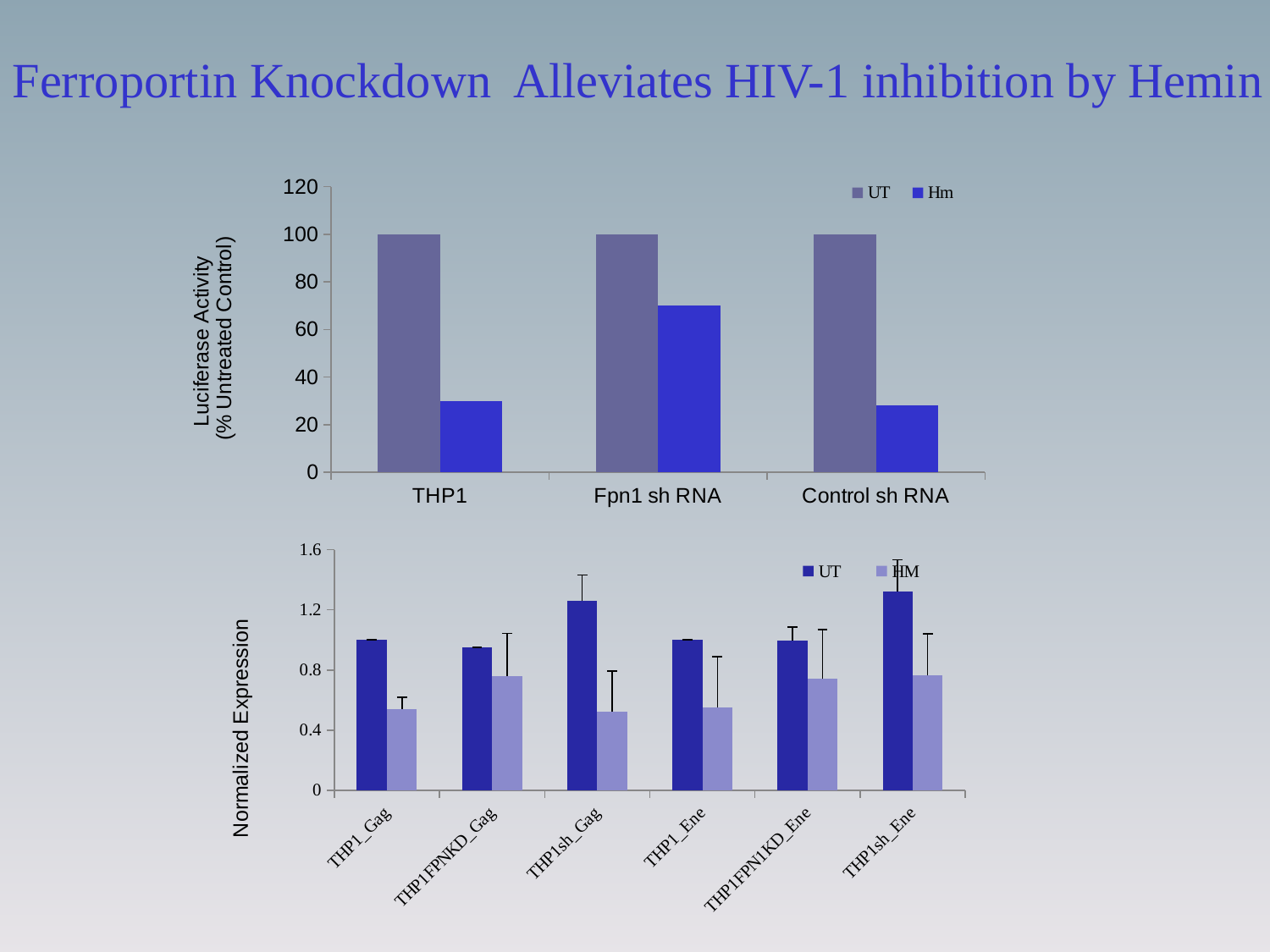
In the top chart (Luciferase Activity), is the Hm value for THP1 greater or less than 40? less In the top chart (Luciferase Activity), how many categories are shown on the x axis? 3 In the bottom chart (Normalized Expression), how many categories are shown on the x axis? 6 In the top chart (Luciferase Activity), is the Hm value for Fpn1 sh RNA greater or less than 60? greater In the top chart, what is the y-axis title? Luciferase Activity (% Untreated Control) In the bottom chart (Normalized Expression), is the UT value for THP1sh_Gag greater or less than 0.8? greater In the top chart (Luciferase Activity), what is the UT value for THP1? 100 In the bottom chart (Normalized Expression), what are the two legend entries? UT and HM What kind of chart is the top chart (Luciferase Activity)? bar chart In the top chart (Luciferase Activity), which category has the highest Hm value? Fpn1 sh RNA In the top chart (Luciferase Activity), how many series does the legend list? 2 In the bottom chart (Normalized Expression), for THP1_Gag, which is larger, the UT value or the HM value? UT